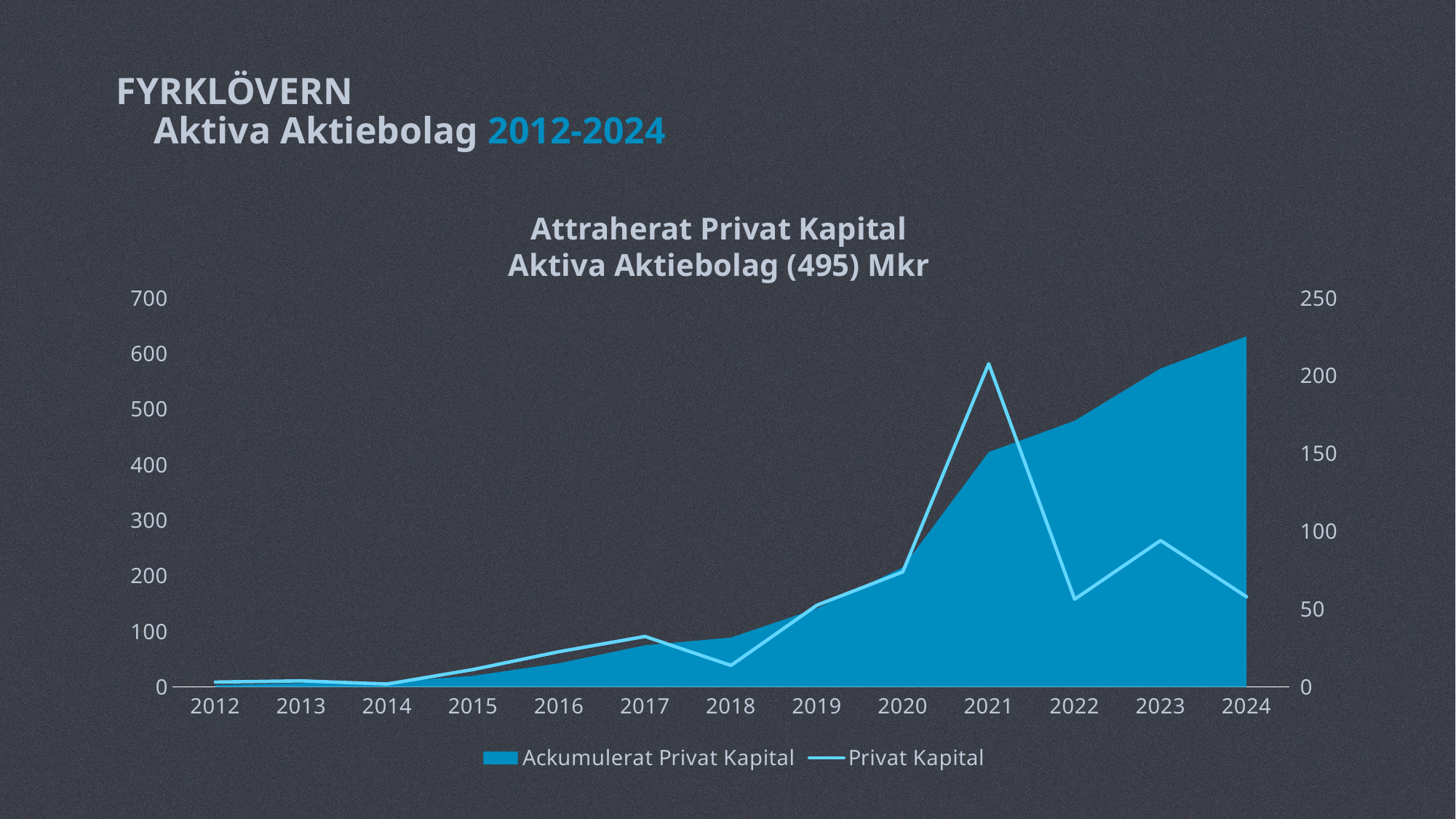
Is the Ackumulerat Privat Kapital value for 2024 greater or less than 600 on the left axis? greater In which year is the Ackumulerat Privat Kapital value highest? 2024 What are the two series named in the legend? Ackumulerat Privat Kapital and Privat Kapital How many years are shown on the x axis of the chart? 13 Is the Ackumulerat Privat Kapital value for 2019 greater or less than 200 on the left axis? less Which year has the larger Privat Kapital value, 2021 or 2022? 2021 Is the Privat Kapital value for 2022 greater or less than 100 on the right axis? less How many series does the chart legend list? 2 In which year does the Privat Kapital line reach its highest value? 2021 Does the Ackumulerat Privat Kapital series generally rise or fall from 2012 to 2024? rise What type of chart is used to draw the Ackumulerat Privat Kapital series? area chart